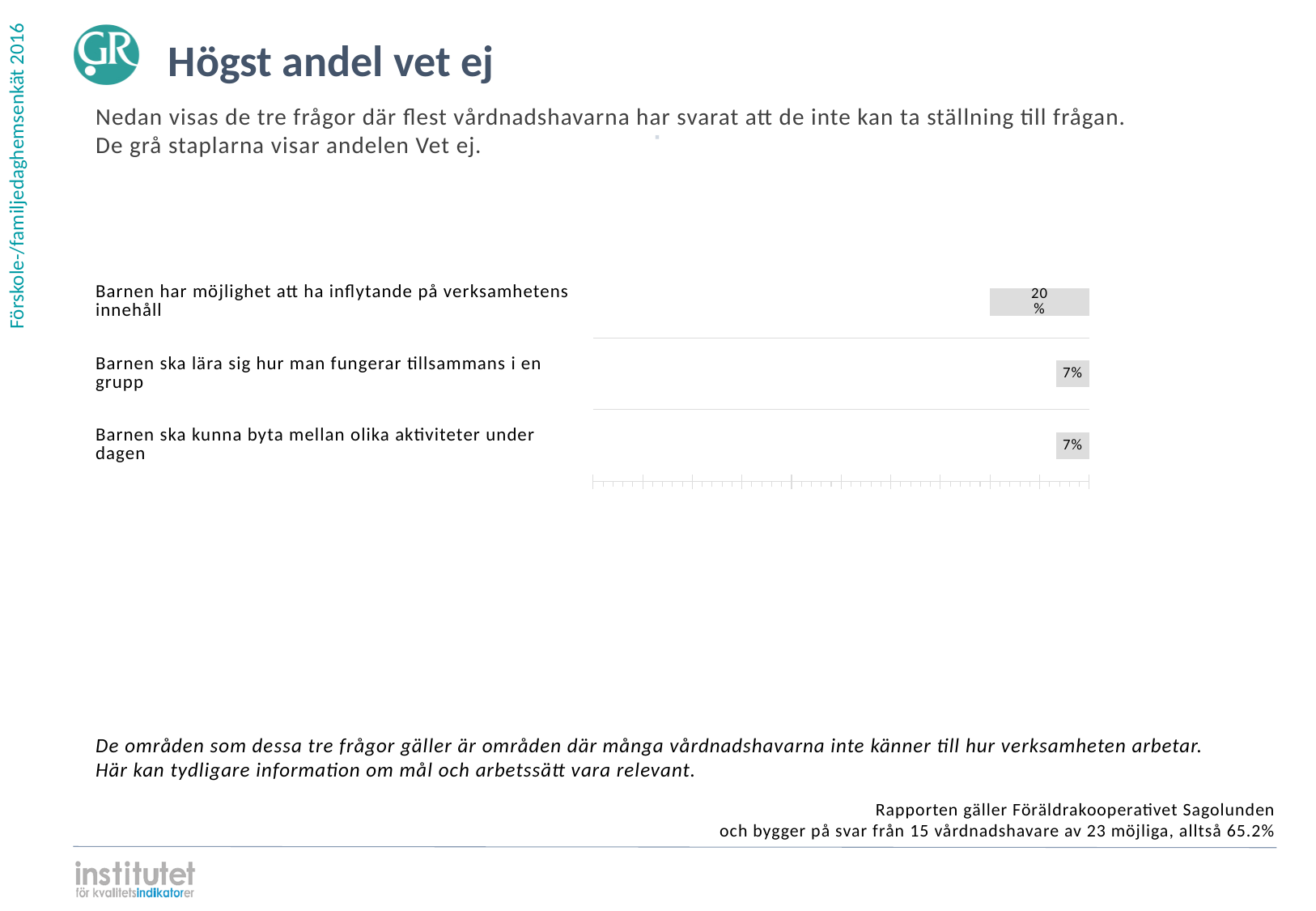
Do the two questions "Barnen ska lära sig hur man fungerar tillsammans i en grupp" and "Barnen ska kunna byta mellan olika aktiviteter under dagen" have the same Vet ej share? Yes, 7% What colour are the bars in the chart? Grey What is the title of the slide containing the chart? Högst andel vet ej What kind of chart is shown on the slide? Bar chart What is the Vet ej share for "Barnen ska kunna byta mellan olika aktiviteter under dagen"? 7% How many questions (categories) are shown in the chart? 3 What is the Vet ej share for "Barnen ska lära sig hur man fungerar tillsammans i en grupp"? 7% Which question has the highest share of Vet ej answers? Barnen har möjlighet att ha inflytande på verksamhetens innehåll Which has a larger Vet ej share: "Barnen har möjlighet att ha inflytande på verksamhetens innehåll" or "Barnen ska kunna byta mellan olika aktiviteter under dagen"? Barnen har möjlighet att ha inflytande på verksamhetens innehåll What is the Vet ej share for "Barnen har möjlighet att ha inflytande på verksamhetens innehåll"? 20% What is the difference between the Vet ej share for "Barnen har möjlighet att ha inflytande på verksamhetens innehåll" and for "Barnen ska lära sig hur man fungerar tillsammans i en grupp"? 13%